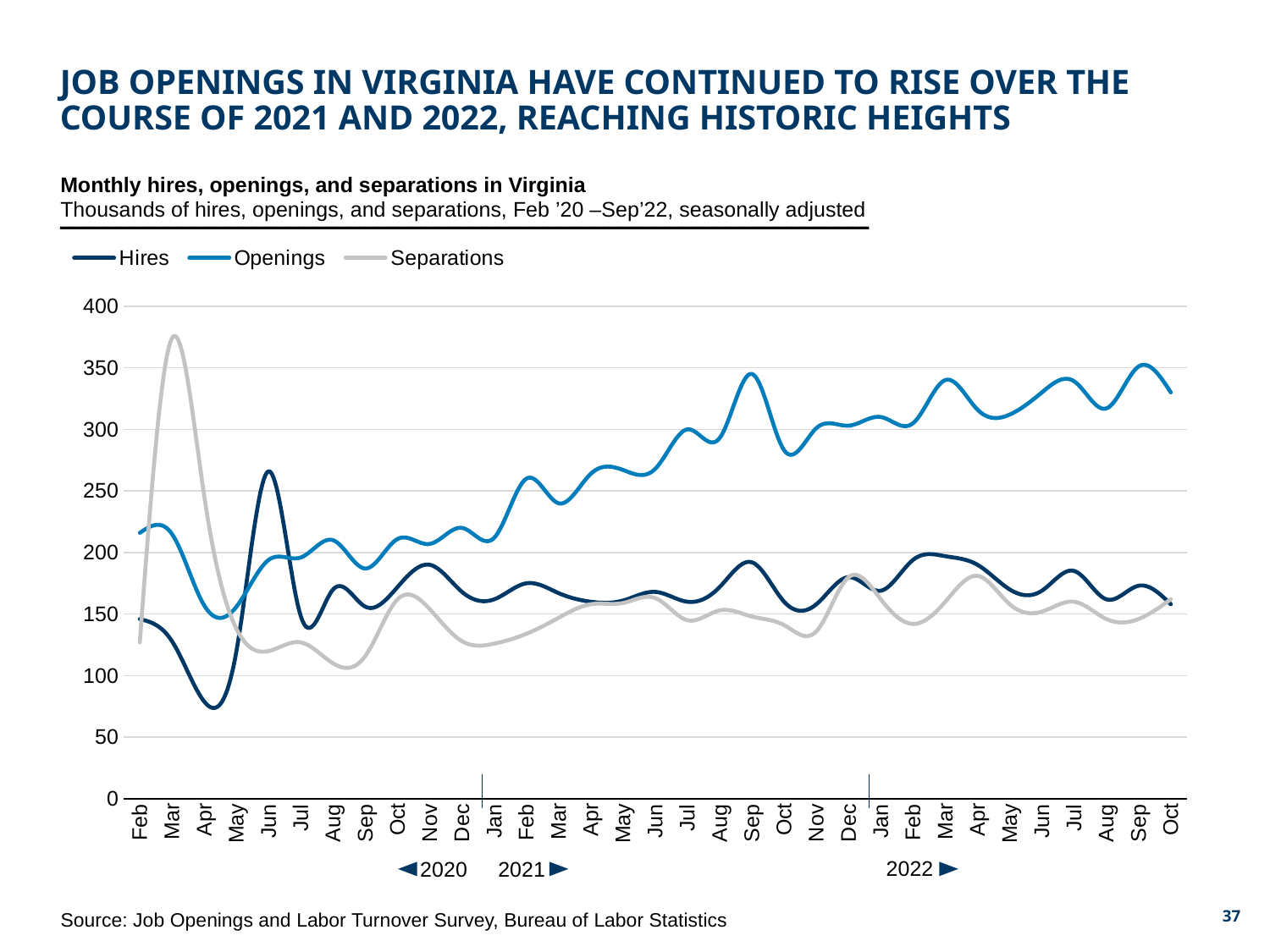
Do Openings generally rise or fall over the course of 2021? rise Is the value for Separations in Mar 2020 greater or less than 350? greater How many series does the legend list? 3 Is the value for Hires in Apr 2020 greater or less than 100? less Is the value for Openings in Oct 2022 greater or less than 300? greater Which is larger in Mar 2020, Separations or Hires? Separations Which series reaches the highest value on the chart in Mar 2020? Separations Which is larger in Oct 2022, Openings or Hires? Openings What kind of chart is shown on the slide? line chart What is the title of the chart? Monthly hires, openings, and separations in Virginia